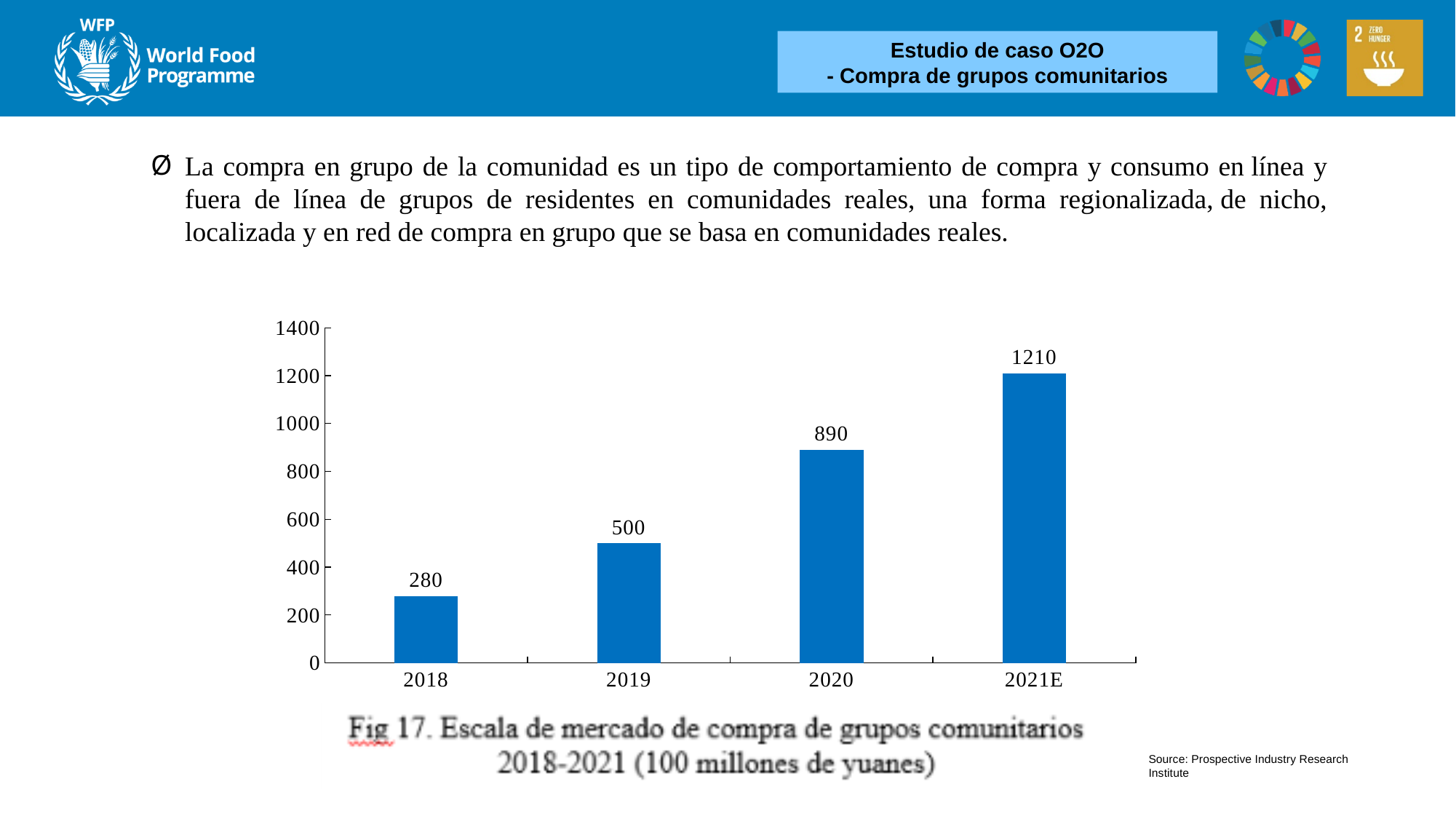
Which year has the highest value? 2021E What is the value for 2021E? 1210 What kind of chart is this? Bar chart What is the value for 2020? 890 What is the value for 2019? 500 What is the value for 2018? 280 Do the values rise or fall from 2018 to 2021E? Rise Which year has the lowest value? 2018 Which is larger, the value for 2019 or the value for 2020? 2020 What is the difference between the values for 2021E and 2020? 320 How many years are shown on the x axis? 4 What is the difference between the values for 2019 and 2018? 220